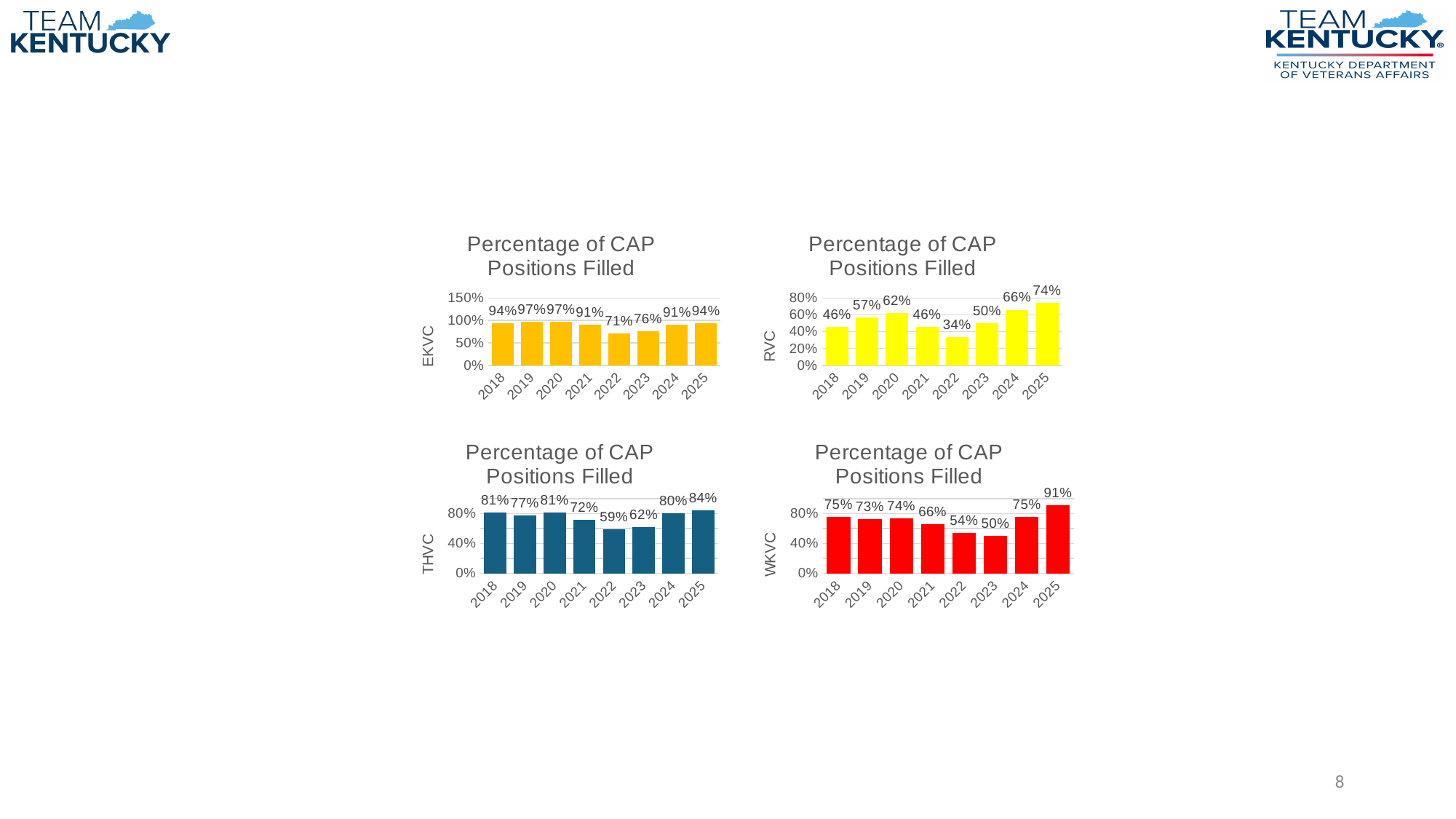
How many charts are on the slide? 4 How many years are shown on the x axis of the bottom-right chart (WKVC)? 8 In the bottom-left chart (THVC), what is the percentage of CAP positions filled in 2019? 77% In the top-left chart (EKVC), what is the percentage of CAP positions filled in 2022? 71% In the bottom-right chart (WKVC), which year has the highest percentage of CAP positions filled? 2025 In the top-left chart (EKVC), which is larger, the value for 2023 or the value for 2024? 2024 In the top-right chart (RVC), what is the percentage of CAP positions filled in 2025? 74% In the bottom-left chart (THVC), what is the difference between the 2025 value and the 2022 value? 25% In the bottom-right chart (WKVC), which year has the lowest percentage of CAP positions filled? 2023 In the top-right chart (RVC), which year has the lowest percentage of CAP positions filled? 2022 In the top-right chart (RVC), is the value for 2024 greater or less than 60%? greater What type of chart is the top-left chart (EKVC)? bar chart